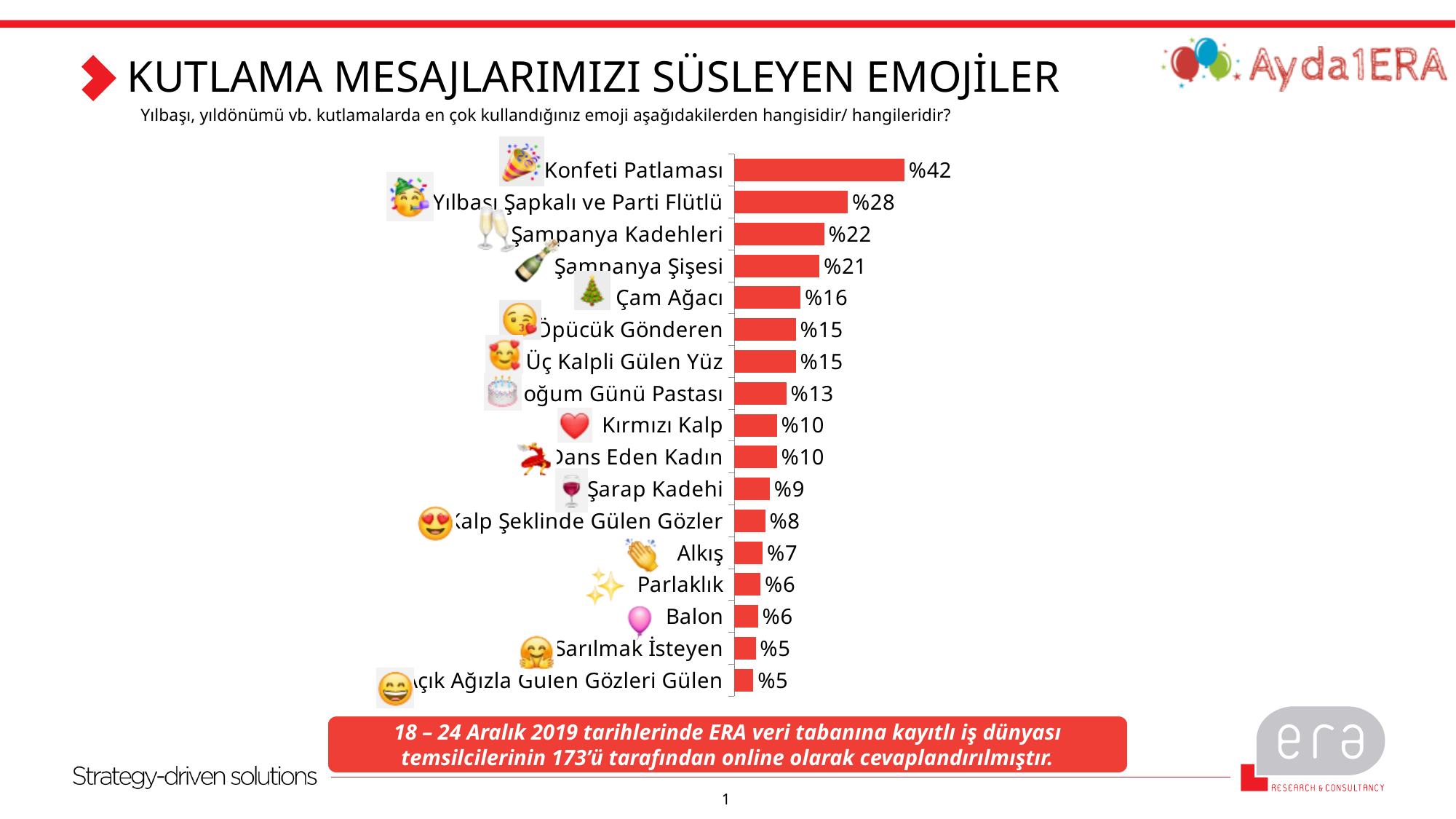
What is the value for Çam Ağacı? %16 How many emoji categories are shown in the chart? 17 What is the value for Alkış? %7 What is the value for Şampanya Kadehleri? %22 Which has a larger value, Şarap Kadehi or Balon? Şarap Kadehi What is the value for Üç Kalpli Gülen Yüz? %15 What is the value for Konfeti Patlaması? %42 What is the difference between the values for Şampanya Şişesi and Kırmızı Kalp? %11 What kind of chart is shown on the slide? bar chart Which emoji has the highest value in the chart? Konfeti Patlaması What is the difference between the values for Konfeti Patlaması and Yılbaşı Şapkalı ve Parti Flütlü? %14 What is the title of the slide containing the chart? KUTLAMA MESAJLARIMIZI SÜSLEYEN EMOJİLER